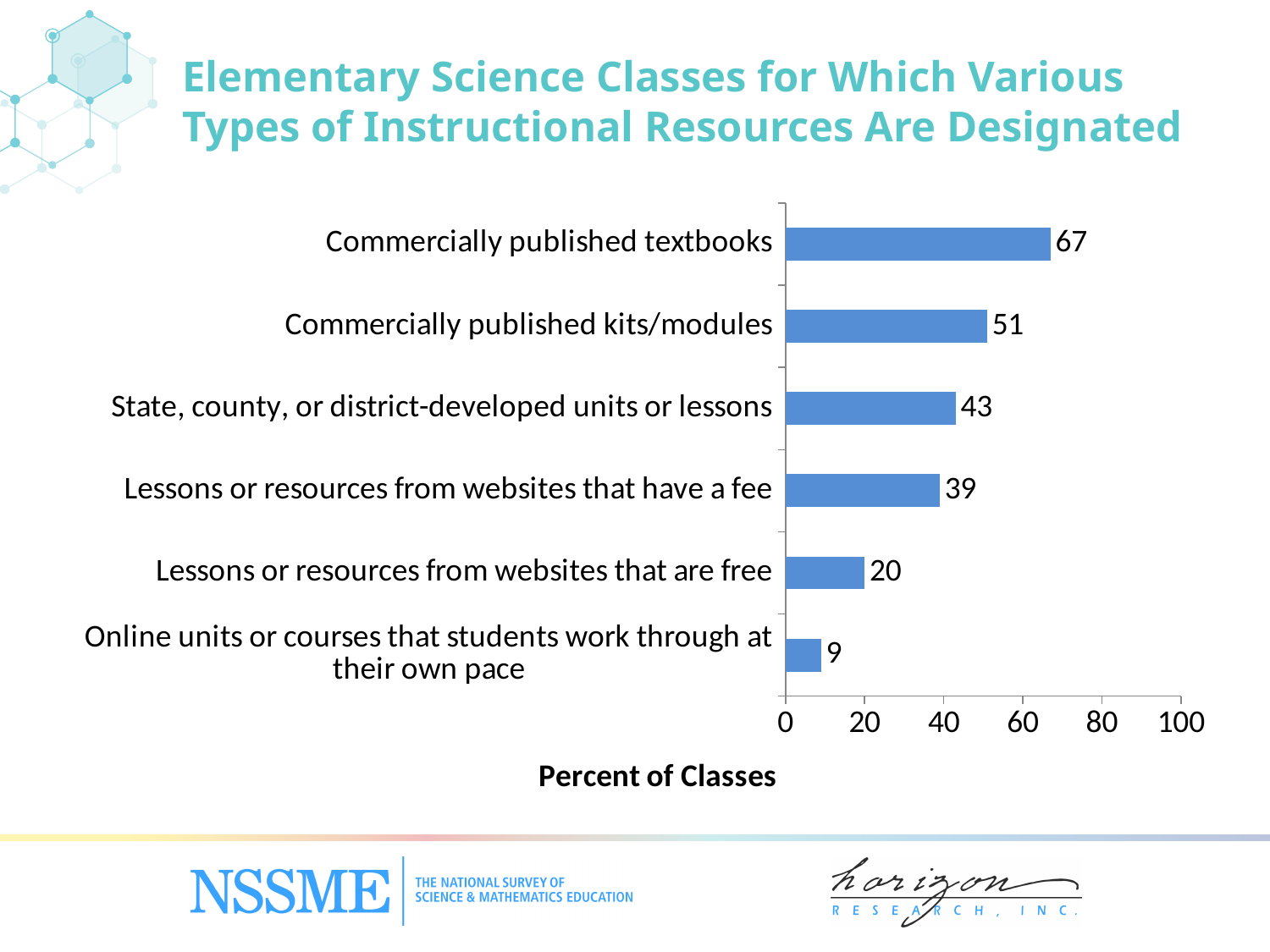
Which type of instructional resource has the highest percent of classes? Commercially published textbooks Is the value for 'Commercially published textbooks' greater or less than 60? greater What is the value for 'Lessons or resources from websites that are free'? 20 What is the value for 'State, county, or district-developed units or lessons'? 43 What kind of chart is shown on the slide? Bar chart What is the difference between the values for lessons or resources from websites that have a fee and those that are free? 19 Which type of instructional resource has the lowest percent of classes? Online units or courses that students work through at their own pace How many types of instructional resources are shown in the chart? 6 Which is larger: the value for 'Commercially published kits/modules' or 'Lessons or resources from websites that have a fee'? Commercially published kits/modules What is the label of the horizontal axis? Percent of Classes What is the difference between the values for commercially published textbooks and commercially published kits/modules? 16 What percent of classes have commercially published textbooks designated as an instructional resource? 67